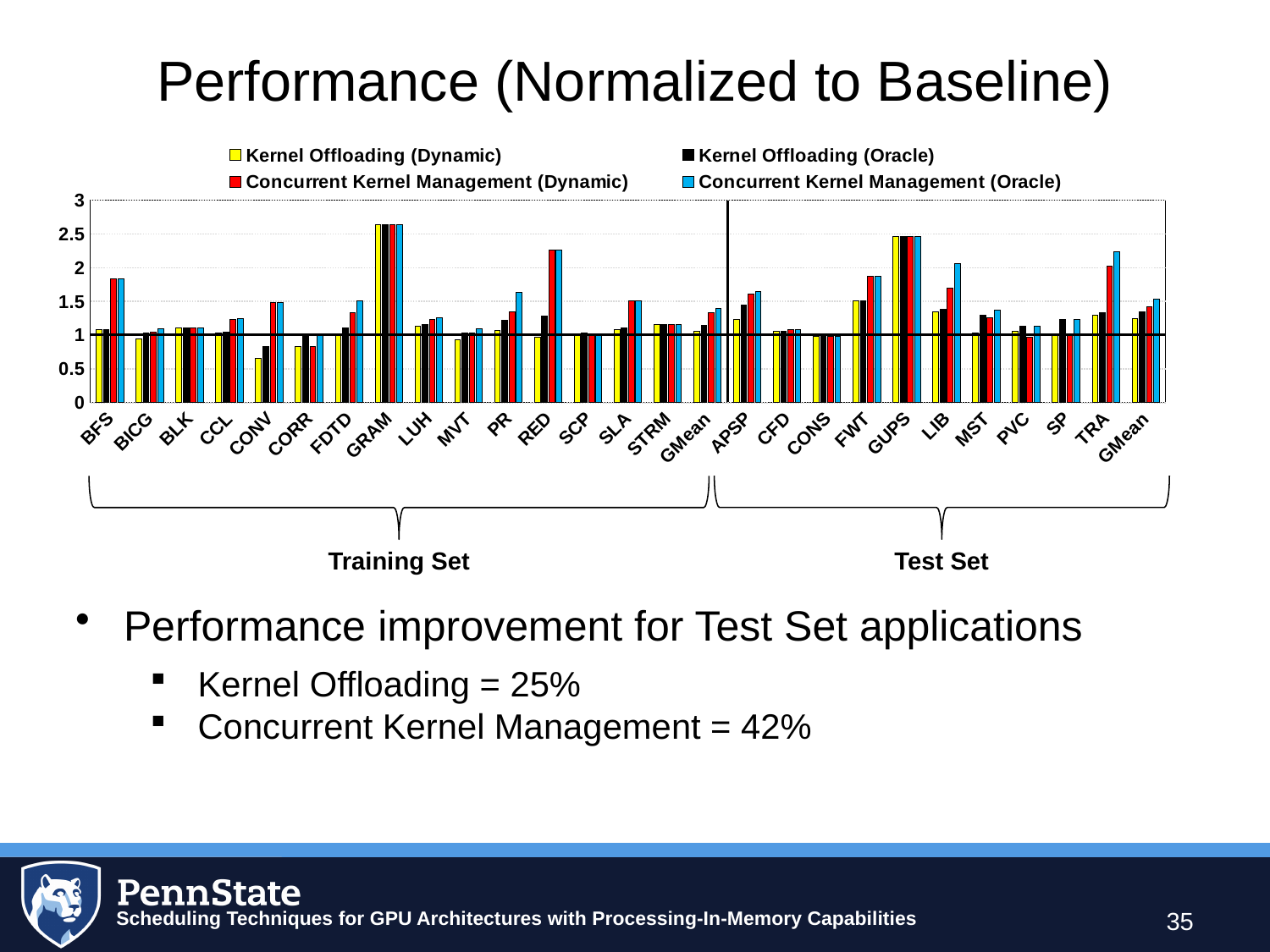
Is the value for CONV in the Kernel Offloading (Dynamic) series greater or less than 1? less How many series does the legend list? 4 How many categories are labelled on the x axis of the chart? 27 What is the title of the chart on the slide? Performance (Normalized to Baseline) Which category has the lowest value in the Kernel Offloading (Dynamic) series? CONV What kind of chart is shown on the slide? bar chart Is the value for BFS in the Concurrent Kernel Management (Dynamic) series greater or less than 1.5? greater Is the value for GRAM in the Concurrent Kernel Management (Dynamic) series greater or less than 2.5? greater How many categories are grouped under the Test Set bracket? 11 Which category has the highest value in the Concurrent Kernel Management (Dynamic) series? GRAM In the Concurrent Kernel Management (Dynamic) series, which is larger, RED or SLA? RED